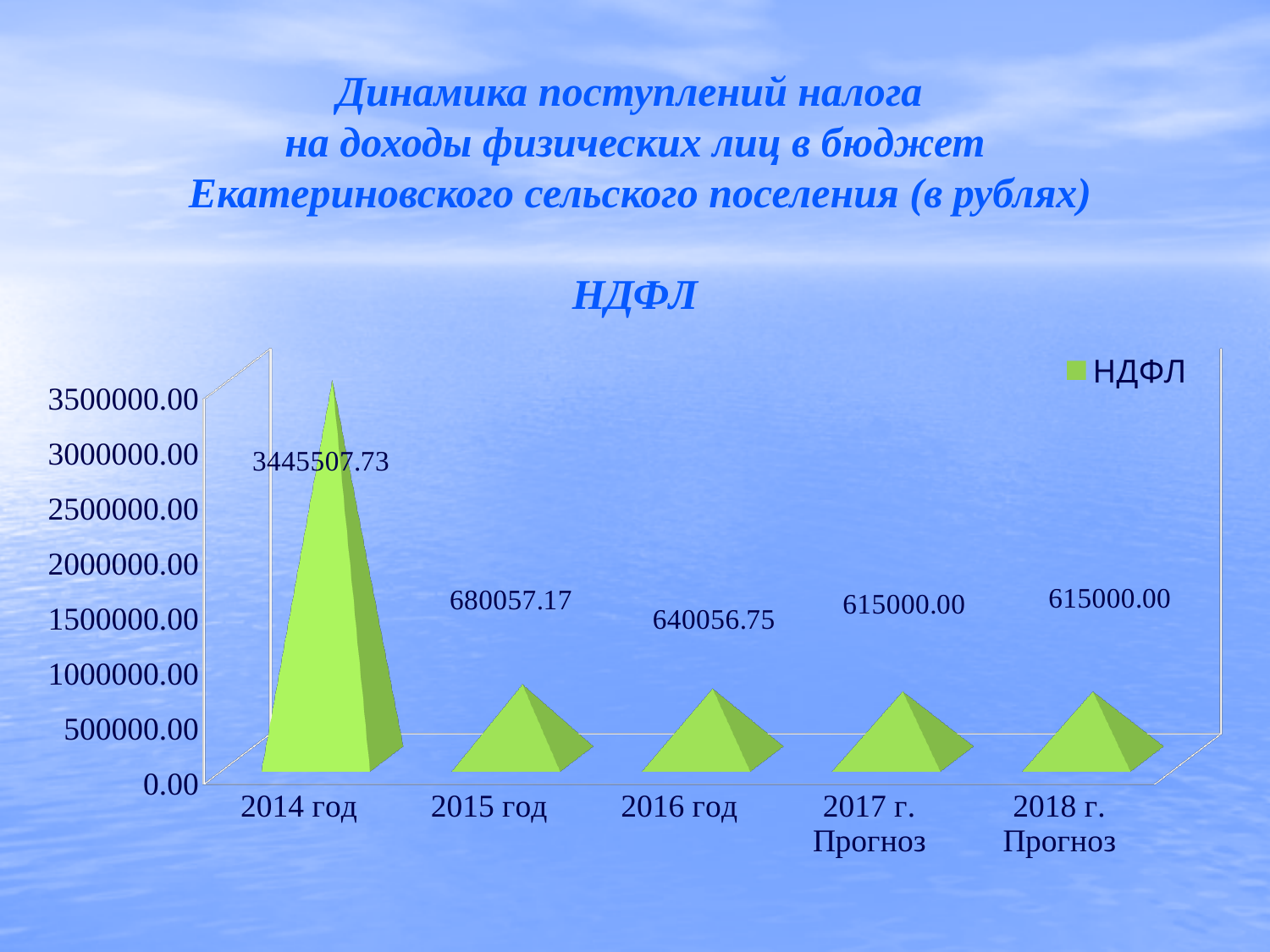
Which category has the highest value? 2014 год How many categories are shown on the x axis? 5 What is the value for 2014 год? 3445507.73 Is the value for 2014 год greater or less than 3000000.00? greater What is the value for 2015 год? 680057.17 How many series does the legend list? 1 What is the value for 2017 г. Прогноз? 615000.00 What is the value for 2016 год? 640056.75 Do the values rise or fall from 2014 год to 2016 год? fall What is the difference between the values for 2014 год and 2015 год? 2765450.56 What is the difference between the values for 2015 год and 2016 год? 40000.42 Which is larger, the value for 2015 год or the value for 2016 год? 2015 год